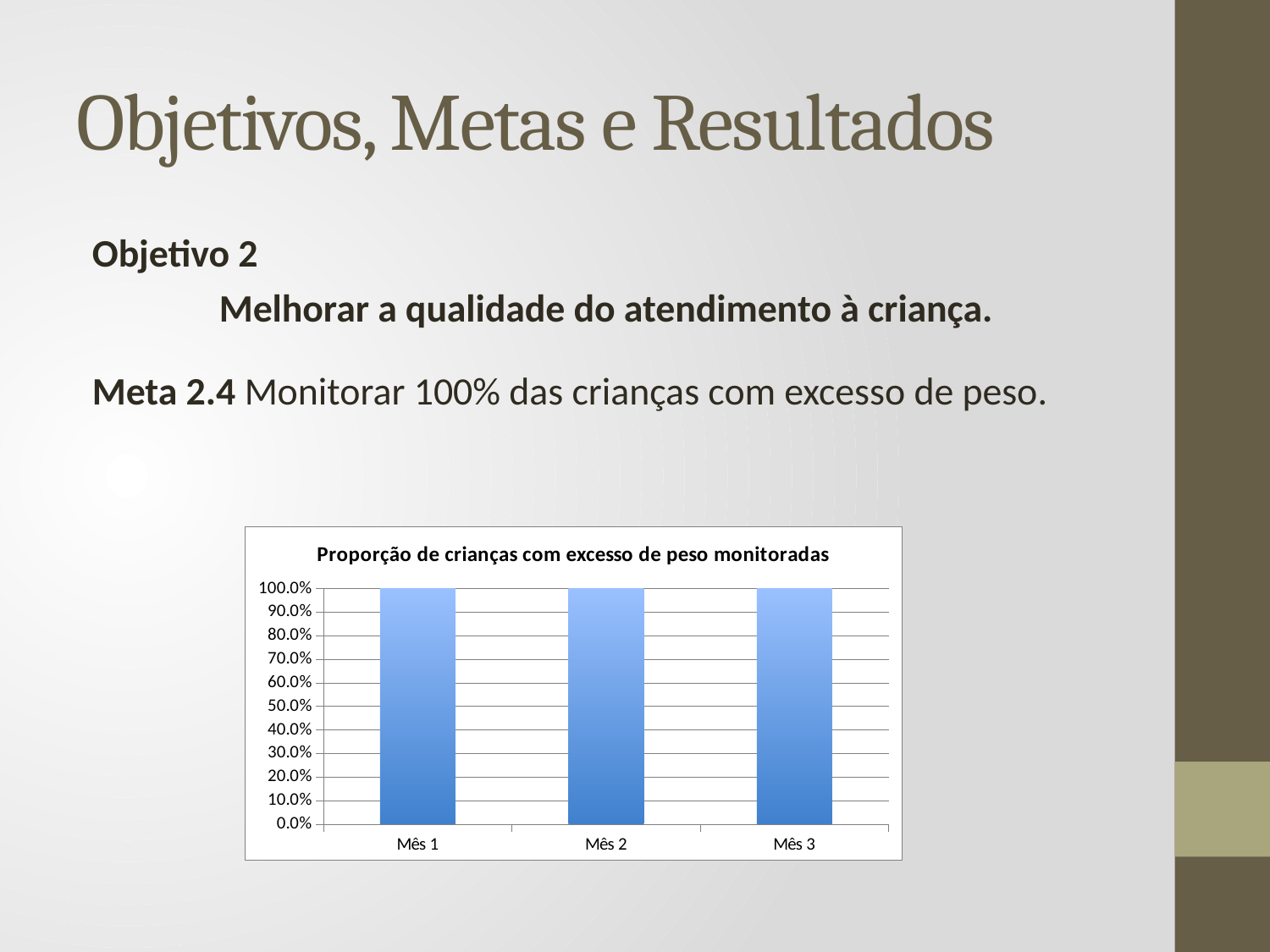
What is the value for Mês 3? 100.0% Do the values rise, fall or stay the same from Mês 1 to Mês 3? stay the same What is the value for Mês 2? 100.0% Is the value for Mês 2 greater or less than 50.0%? greater What is the highest value shown on the y axis? 100.0% What is the value for Mês 1? 100.0% What is the title of the chart? Proporção de crianças com excesso de peso monitoradas What kind of chart is shown on the slide? bar chart What is the difference between the values for Mês 1 and Mês 3? 0.0% How many categories are shown on the x axis? 3 Is the value for Mês 3 greater or less than 90.0%? greater